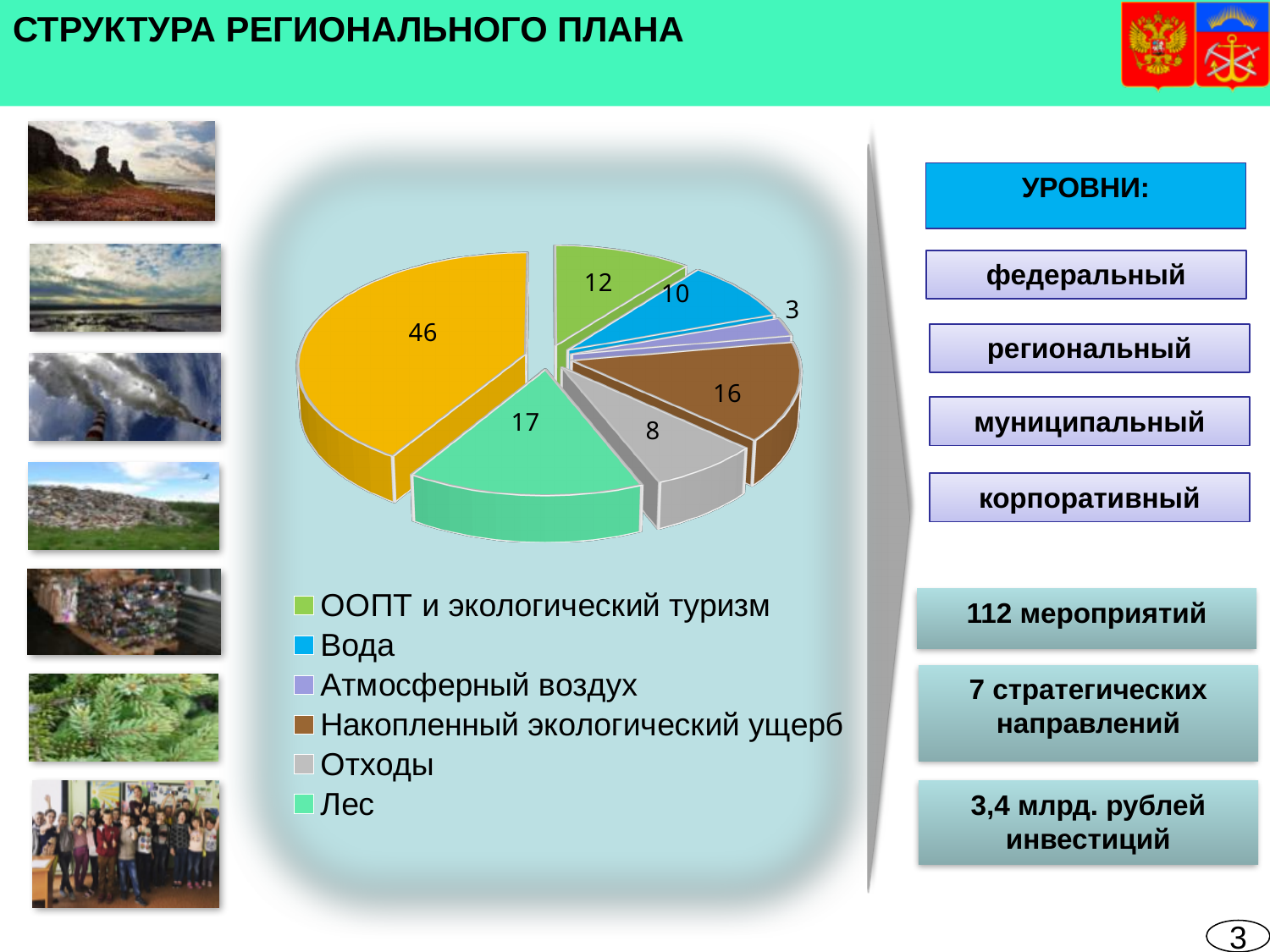
What is the value of the slice for ООПТ и экологический туризм? 12 What is the value of the slice for Накопленный экологический ущерб? 16 Which legend category has the smallest slice? Атмосферный воздух What is the difference between the values for Лес and Отходы? 9 What is the value of the slice for Отходы? 8 What is the value of the slice for Лес? 17 What is the value of the largest slice in the pie chart? 46 What kind of chart is shown on the slide? pie chart What is the value of the slice for Вода? 10 How many slices does the pie chart have? 7 How many entries does the legend list? 6 Which is larger, the slice for Вода or the slice for Накопленный экологический ущерб? Накопленный экологический ущерб